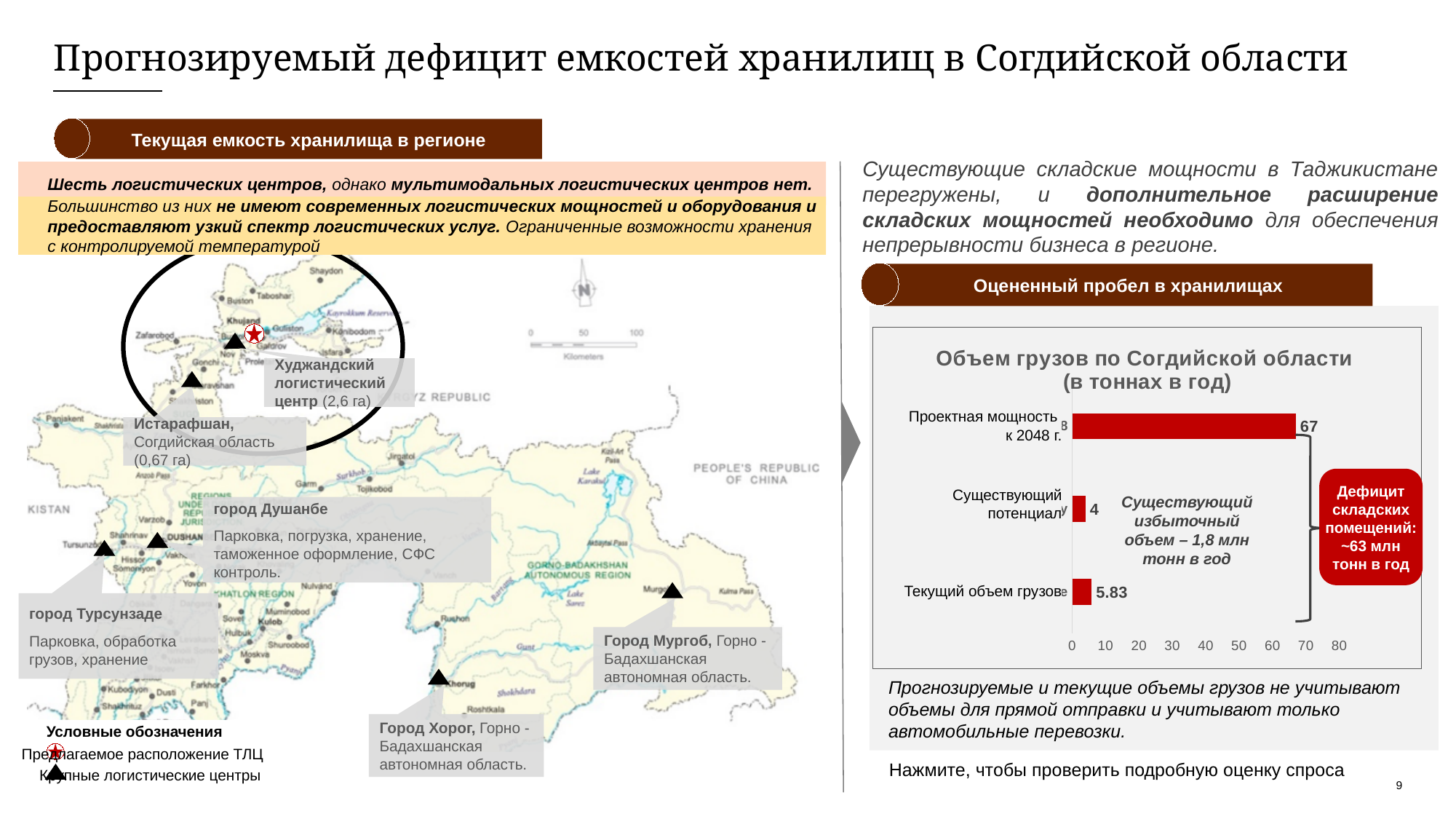
What is the value for "Текущий объем грузов" in the chart? 5.83 How many categories are shown in the chart "Объем грузов по Согдийской области"? 3 Which is larger: "Текущий объем грузов" or "Существующий потенциал"? Текущий объем грузов What is the value for "Проектная мощность к 2048 г." in the chart "Объем грузов по Согдийской области"? 67 What unit is stated in the chart title "Объем грузов по Согдийской области"? в тоннах в год What is the difference between "Текущий объем грузов" and "Существующий потенциал"? 1.83 Which category has the lowest value in the chart? Существующий потенциал Is the value for "Проектная мощность к 2048 г." greater or less than 60? greater Which category has the highest value in the chart "Объем грузов по Согдийской области"? Проектная мощность к 2048 г. What type of chart is "Объем грузов по Согдийской области"? bar chart What is the difference between "Проектная мощность к 2048 г." and "Существующий потенциал"? 63 What is the value for "Существующий потенциал" in the chart? 4